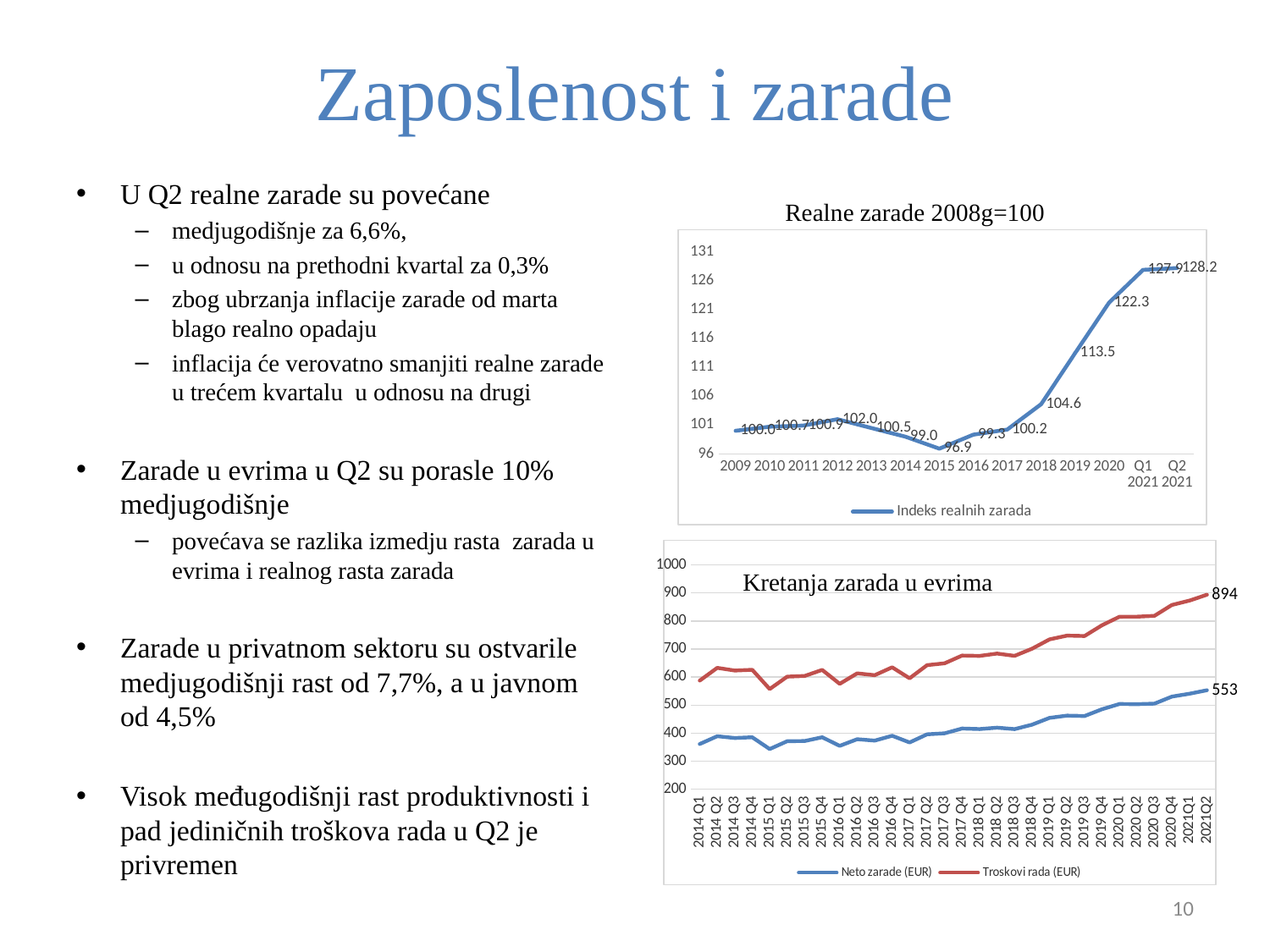
What kind of chart is the 'Realne zarade 2008g=100' chart? line chart In the 'Realne zarade 2008g=100' chart, do the values rise or fall from 2017 to Q2 2021? rise In the 'Realne zarade 2008g=100' chart, what is the value of Indeks realnih zarada for 2015? 96.9 In the 'Kretanja zarada u evrima' chart, what is the difference between Troskovi rada (EUR) and Neto zarade (EUR) in 2021Q2? 341 In the 'Realne zarade 2008g=100' chart, which year has the lowest value? 2015 How many series does the legend of the 'Kretanja zarada u evrima' chart list? 2 In the 'Kretanja zarada u evrima' chart, is the value of Neto zarade (EUR) for 2014 Q1 greater or less than 400? less In the 'Realne zarade 2008g=100' chart, which point has the highest value? Q2 2021 In the 'Kretanja zarada u evrima' chart, what is the value of Troskovi rada (EUR) for 2021Q2? 894 How many data points are plotted in the 'Realne zarade 2008g=100' chart? 14 In the 'Realne zarade 2008g=100' chart, which is larger, the value for 2012 or the value for 2014? 2012 In the 'Realne zarade 2008g=100' chart, what is the difference between the values for 2020 and 2019? 8.8